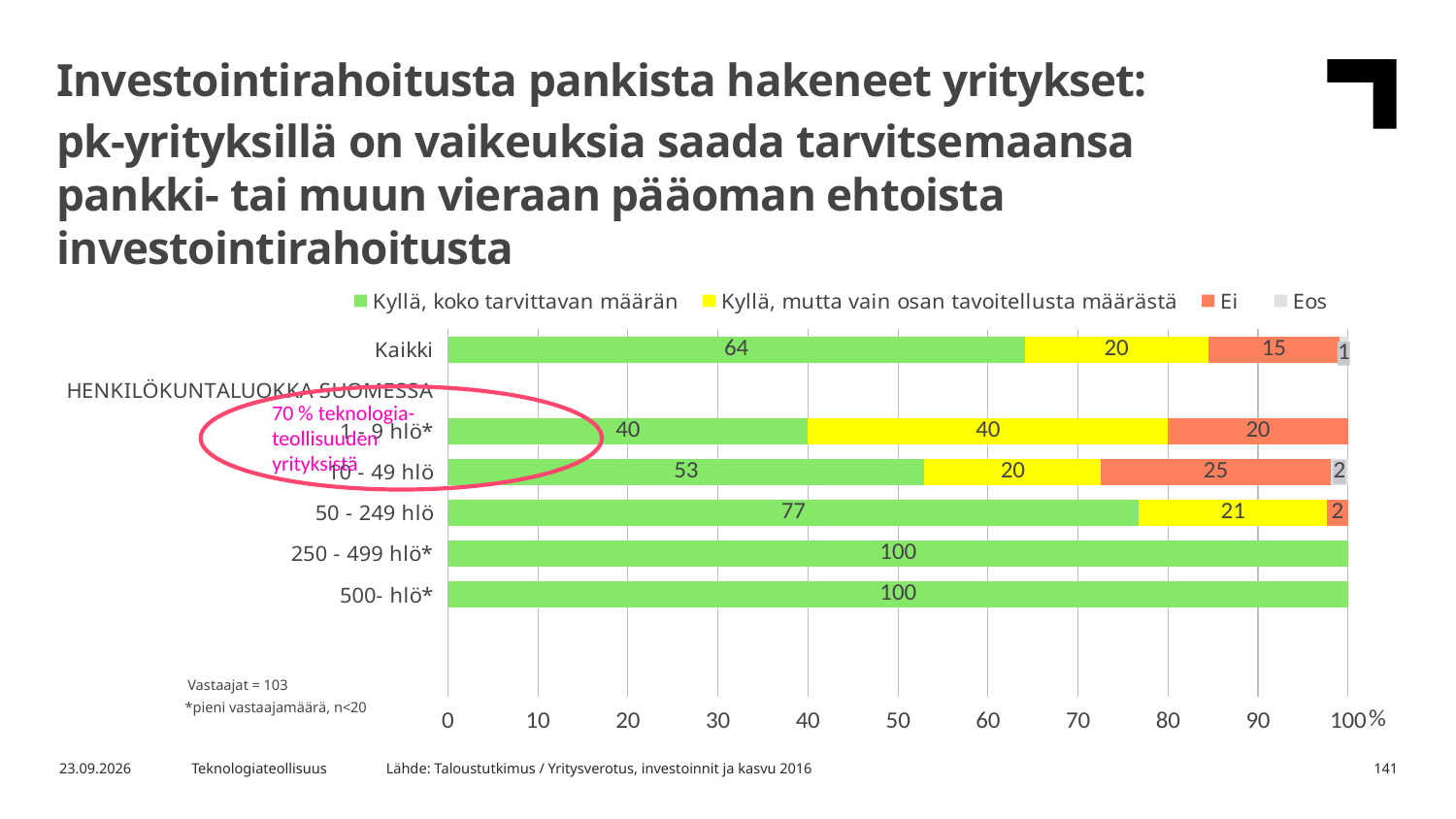
What is the value of 'Kyllä, mutta vain osan tavoitellusta määrästä' for the category '1 - 9 hlö*'? 40 What is the difference between the 'Kyllä, koko tarvittavan määrän' values for '50 - 249 hlö' and '10 - 49 hlö'? 24 What is the value of 'Kyllä, koko tarvittavan määrän' for the category '500- hlö*'? 100 Which series is shown in green in the chart? Kyllä, koko tarvittavan määrän How many series does the legend list? 4 What is the value of 'Kyllä, koko tarvittavan määrän' for the category 'Kaikki'? 64 What kind of chart is shown on the slide? stacked bar chart Which category has the lowest value for 'Kyllä, koko tarvittavan määrän'? 1 - 9 hlö* Which is larger: the 'Ei' value for '1 - 9 hlö*' or the 'Ei' value for 'Kaikki'? 1 - 9 hlö* How many categories are shown on the vertical axis of the chart? 6 What is the value of 'Ei' for the category '10 - 49 hlö'? 25 What is the value of 'Eos' for the category 'Kaikki'? 1